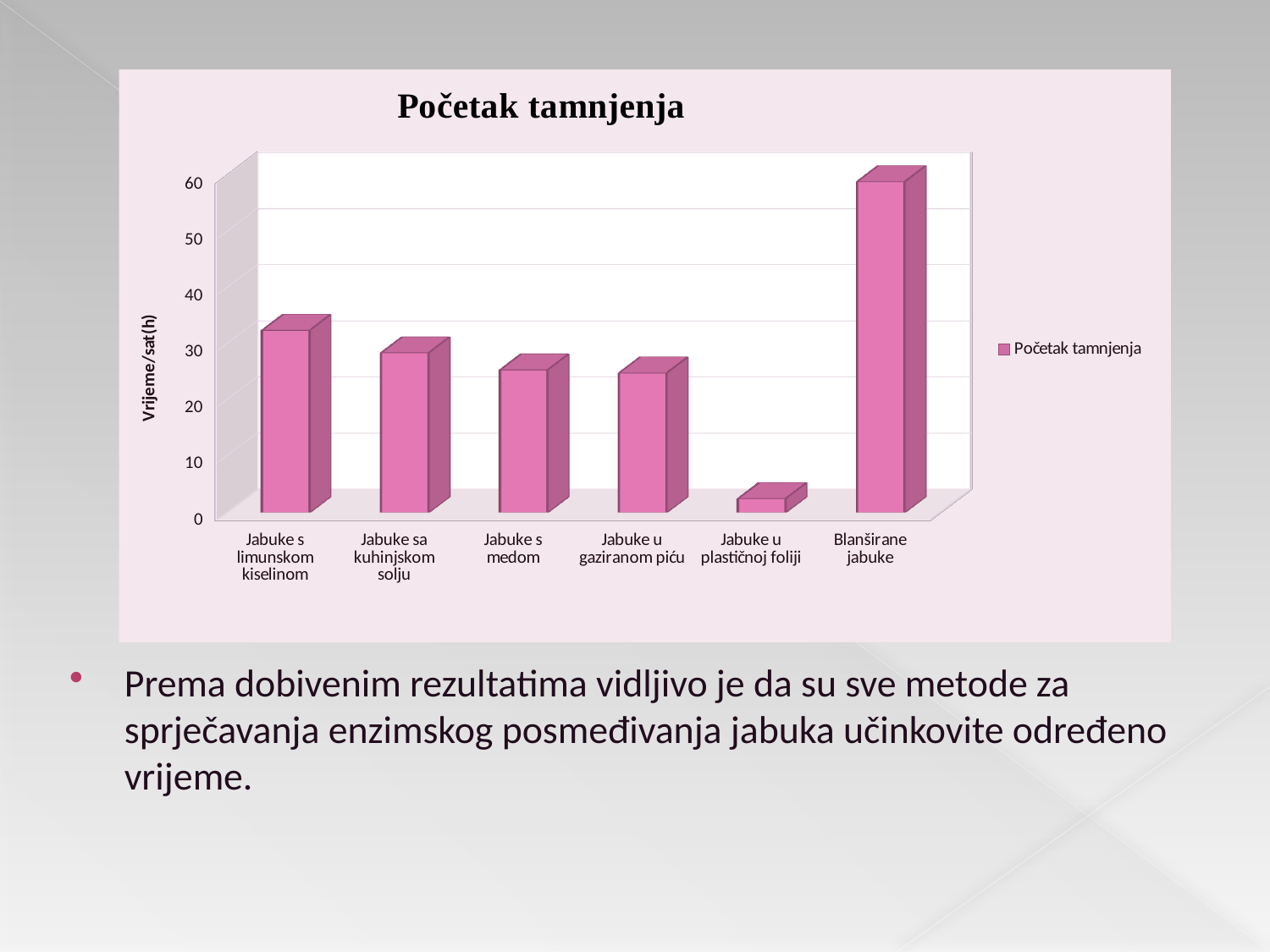
What is the title of the chart? Početak tamnjenja What is the label of the vertical axis? Vrijeme/sat(h) Is the value for Blanširane jabuke greater or less than 50? greater How many series does the legend list? 1 Which has a larger value, Blanširane jabuke or Jabuke s limunskom kiselinom? Blanširane jabuke How many categories are shown on the x axis? 6 Which category has the lowest value? Jabuke u plastičnoj foliji Which category has the highest value? Blanširane jabuke Is the value for Jabuke s medom greater or less than 30? less Is the value for Jabuke u plastičnoj foliji greater or less than 10? less What type of chart is shown on the slide? bar chart Which has a larger value, Jabuke s limunskom kiselinom or Jabuke u plastičnoj foliji? Jabuke s limunskom kiselinom